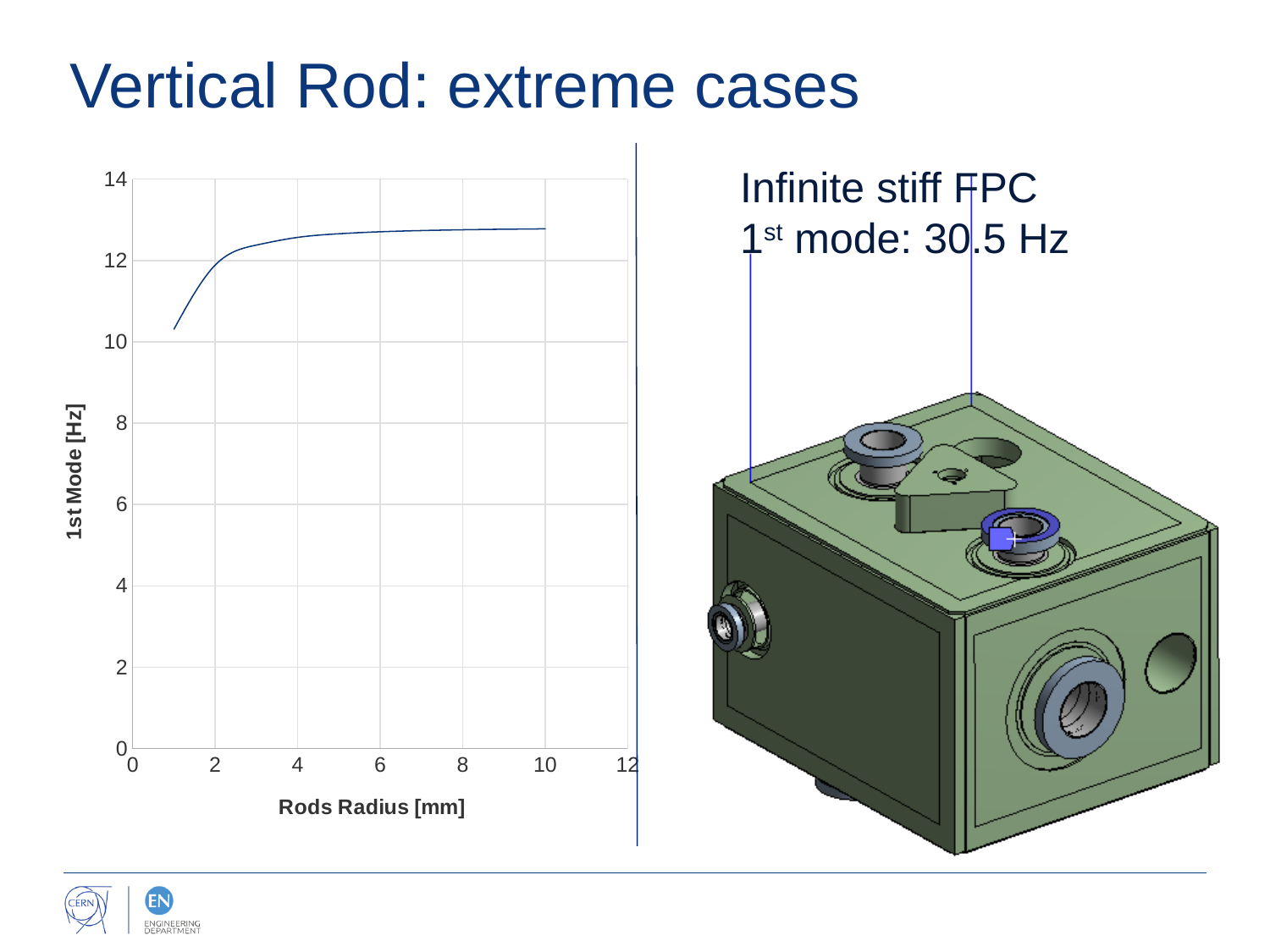
What kind of chart is shown on the left of the slide? line chart What is the label of the x axis of the chart? Rods Radius [mm] Is the 1st mode value at a rods radius of 10 mm greater or less than 12? greater Is the 1st mode value at a rods radius of 1 mm greater or less than 8? greater Is the 1st mode value at a rods radius of 6 mm greater or less than 14? less What is the highest tick value shown on the y axis of the chart? 14 Does the 1st mode frequency rise or fall as the rods radius increases? rise What is the label of the y axis of the chart? 1st Mode [Hz] Which has the higher 1st mode value, a rods radius of 1 mm or a rods radius of 8 mm? 8 mm